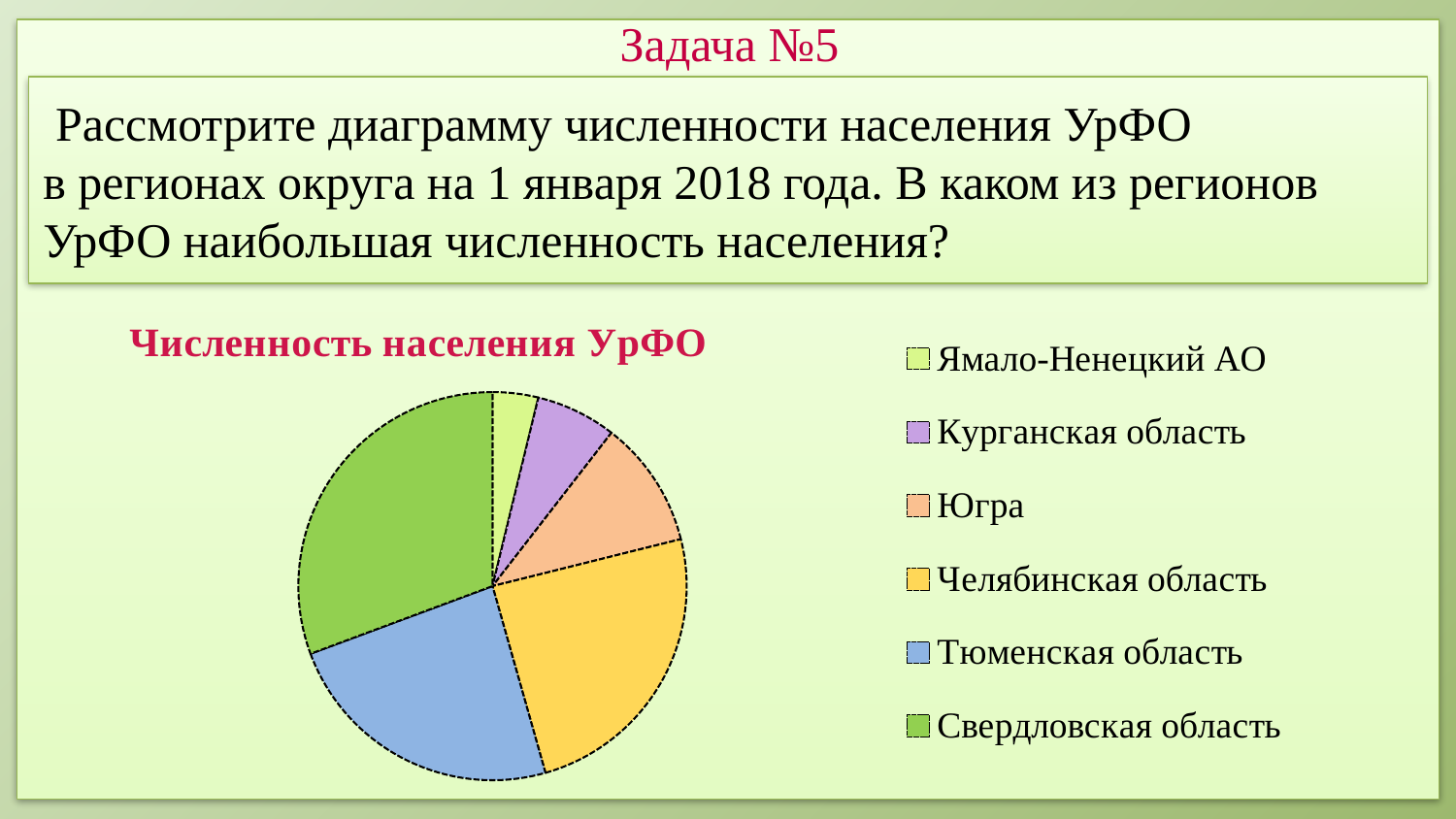
Which region has the smallest slice of the pie? Ямало-Ненецкий АО Which slice is larger: Челябинская область or Курганская область? Челябинская область What is the title of the chart? Численность населения УрФО What colour represents Тюменская область in the pie chart? blue Which region has the largest slice of the pie? Свердловская область Which slice is larger: Тюменская область or Югра? Тюменская область What kind of chart is shown on the slide? pie chart Which slice is larger: Свердловская область or Югра? Свердловская область How many regions (slices) does the pie chart show? 6 How many entries does the legend list? 6